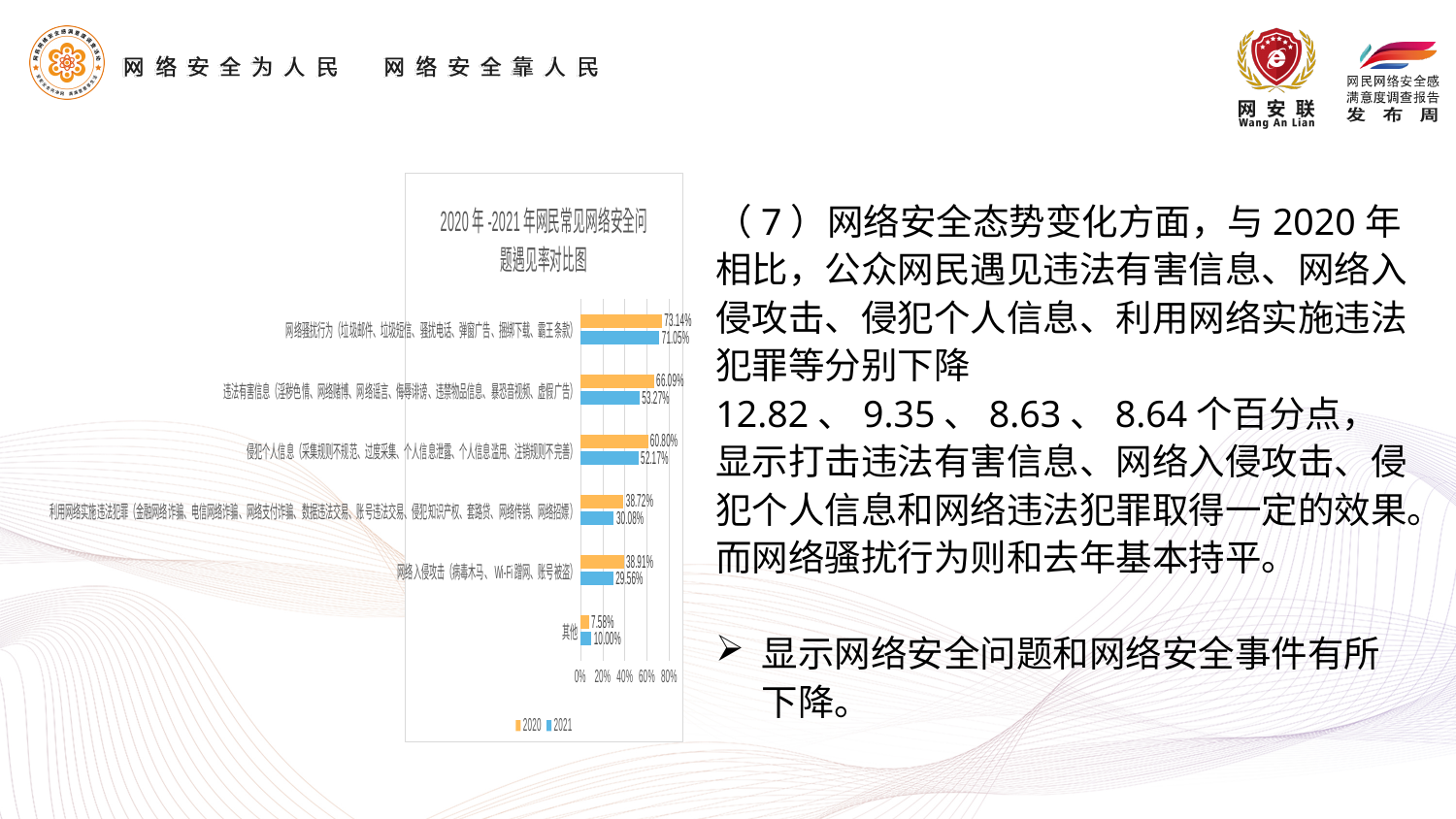
图表中“违法有害信息”2020年与2021年的遇见率相差多少个百分点？ 12.82 图表中2020年遇见率最低的类别是哪一个？ 其他 图表的标题是什么？ 2020年-2021年网民常见网络安全问题遇见率对比图 图表中2021年遇见率最高的类别是哪一个？ 网络骚扰行为 图表中2021年“网络入侵攻击”的遇见率是多少？ 29.56% 这是什么类型的图表？ 条形图 图表中“其他”类别2020年和2021年哪一年的遇见率更高？ 2021 图表中2020年“侵犯个人信息”的遇见率是多少？ 60.80% 图表中共有多少个类别？ 6 图表中2020年“网络骚扰行为”的遇见率是多少？ 73.14% 图表中2021年“违法有害信息”的遇见率是多少？ 53.27% 图表的图例列出了多少个系列？ 2